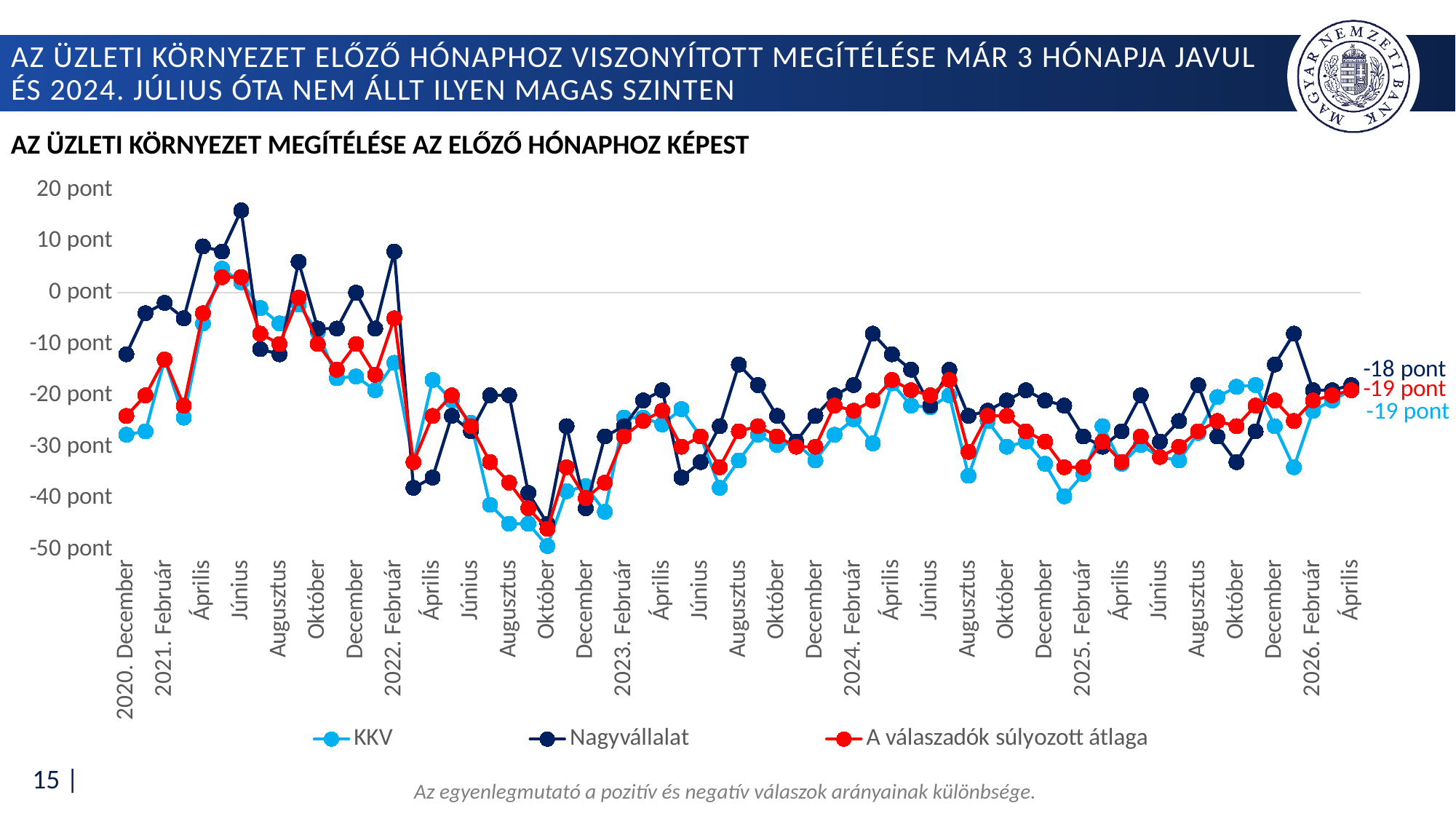
What kind of chart is shown on the slide? line chart What is the value for KKV at the last point (2026. Április)? -19 pont Is the value for Nagyvállalat in 2021. Június greater or less than 10 pont? greater Does the Nagyvállalat series rise or fall between 2021. Június and 2022. Október? fall Which series has the highest value at the last point (2026. Április)? Nagyvállalat What is the value for Nagyvállalat at the last point (2026. Április)? -18 pont How many series does the legend list? 3 Is the value for KKV in 2022. Október greater or less than -40 pont? less At the last point (2026. Április), which is higher: Nagyvállalat or KKV? Nagyvállalat What is the title of the chart? AZ ÜZLETI KÖRNYEZET MEGÍTÉLÉSE AZ ELŐZŐ HÓNAPHOZ KÉPEST What is the value for A válaszadók súlyozott átlaga at the last point (2026. Április)? -19 pont At the last point (2026. Április), what is the difference between the Nagyvállalat value and the KKV value? 1 pont